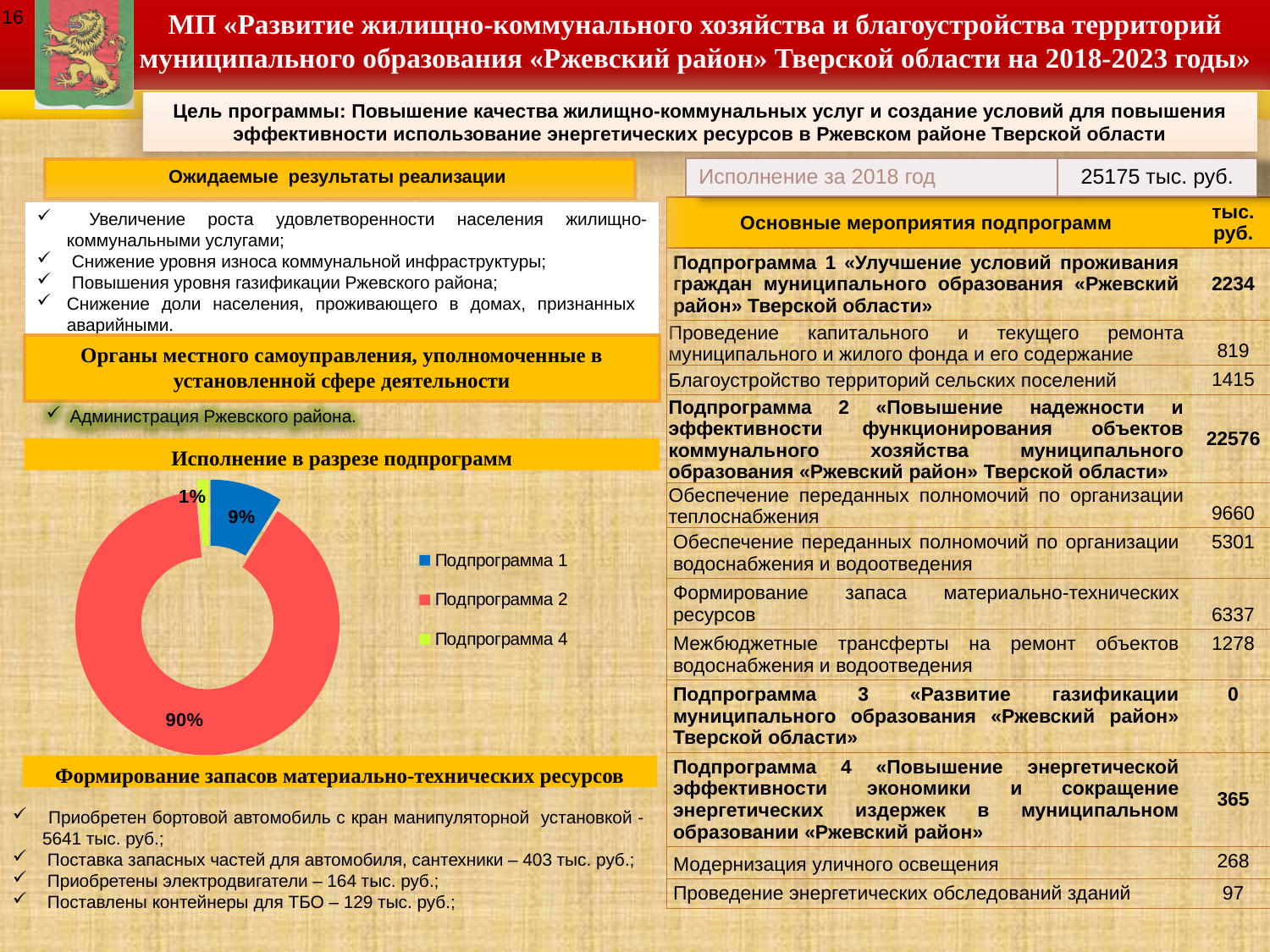
In the chart "Исполнение в разрезе подпрограмм", what share is shown for Подпрограмма 2? 90% In the chart "Исполнение в разрезе подпрограмм", which subprogram has the smallest share? Подпрограмма 4 In the chart "Исполнение в разрезе подпрограмм", which has the larger share, Подпрограмма 1 or Подпрограмма 4? Подпрограмма 1 In the chart "Исполнение в разрезе подпрограмм", which subprogram has the largest share? Подпрограмма 2 In the chart "Исполнение в разрезе подпрограмм", what share is shown for Подпрограмма 1? 9% How many slices does the chart "Исполнение в разрезе подпрограмм" have? 3 In the chart "Исполнение в разрезе подпрограмм", by how many percentage points does the share of Подпрограмма 2 exceed that of Подпрограмма 1? 81 percentage points What kind of chart is "Исполнение в разрезе подпрограмм"? doughnut chart In the chart "Исполнение в разрезе подпрограмм", what is the total of the three labelled shares? 100% In the chart "Исполнение в разрезе подпрограмм", what colour represents Подпрограмма 2? red In the chart "Исполнение в разрезе подпрограмм", what share is shown for Подпрограмма 4? 1% How many entries does the legend of the chart "Исполнение в разрезе подпрограмм" list? 3